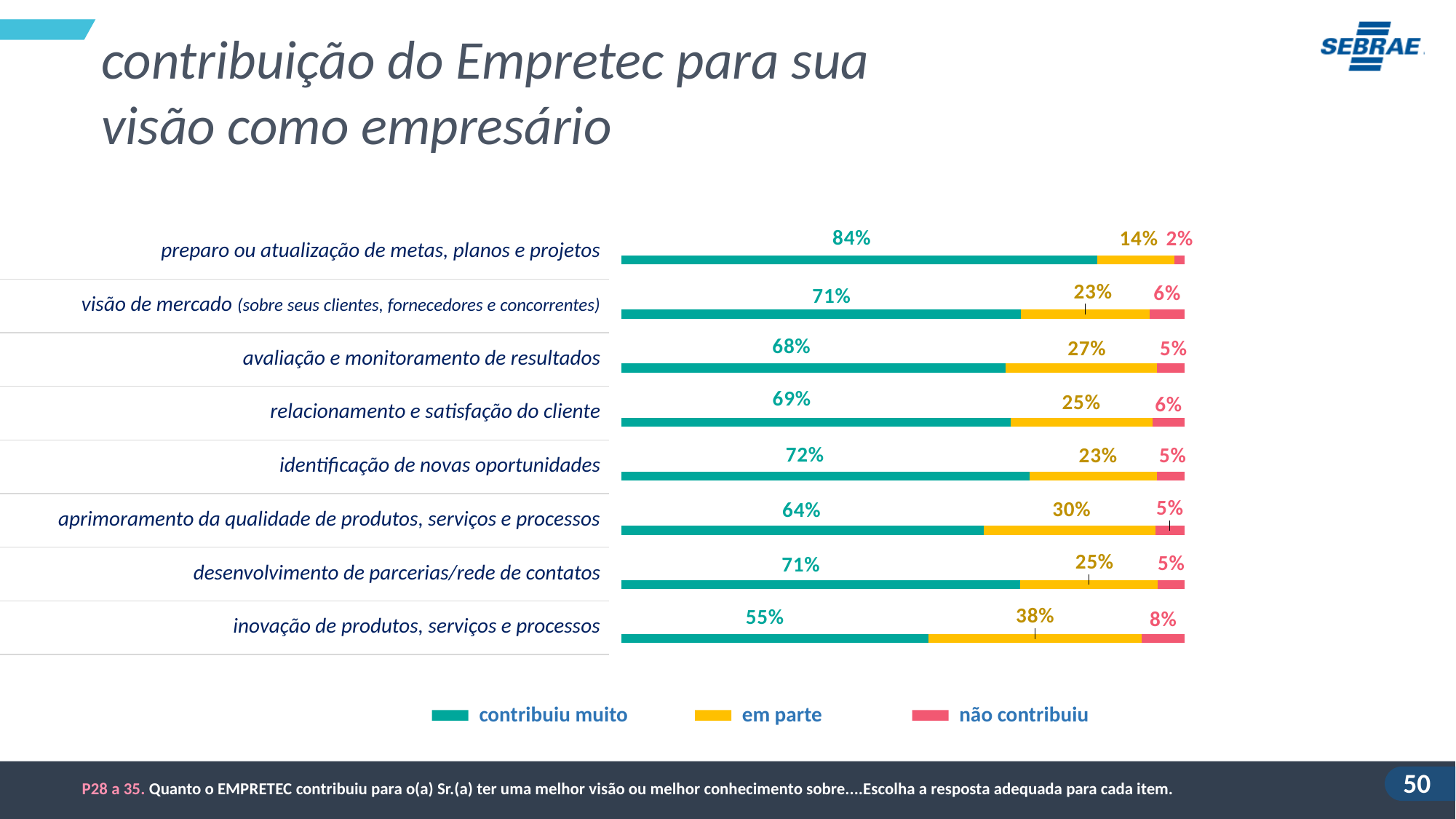
Which category has the highest 'contribuiu muito' percentage? preparo ou atualização de metas, planos e projetos What is the 'em parte' value for 'inovação de produtos, serviços e processos'? 38% What is the 'não contribuiu' value for 'visão de mercado'? 6% Which category has the highest 'não contribuiu' percentage? inovação de produtos, serviços e processos What is the total of the stacked bar for 'relacionamento e satisfação do cliente'? 100% How many series does the legend list? 3 Which category has the lowest 'contribuiu muito' percentage? inovação de produtos, serviços e processos What is the difference between the 'contribuiu muito' values for 'preparo ou atualização de metas, planos e projetos' and 'inovação de produtos, serviços e processos'? 29 percentage points How many categories (items) are shown in the chart? 8 What type of chart is shown on the slide? Stacked bar chart Which has a larger 'em parte' value: 'avaliação e monitoramento de resultados' or 'identificação de novas oportunidades'? avaliação e monitoramento de resultados What percentage of respondents said Empretec 'contribuiu muito' for 'preparo ou atualização de metas, planos e projetos'? 84%